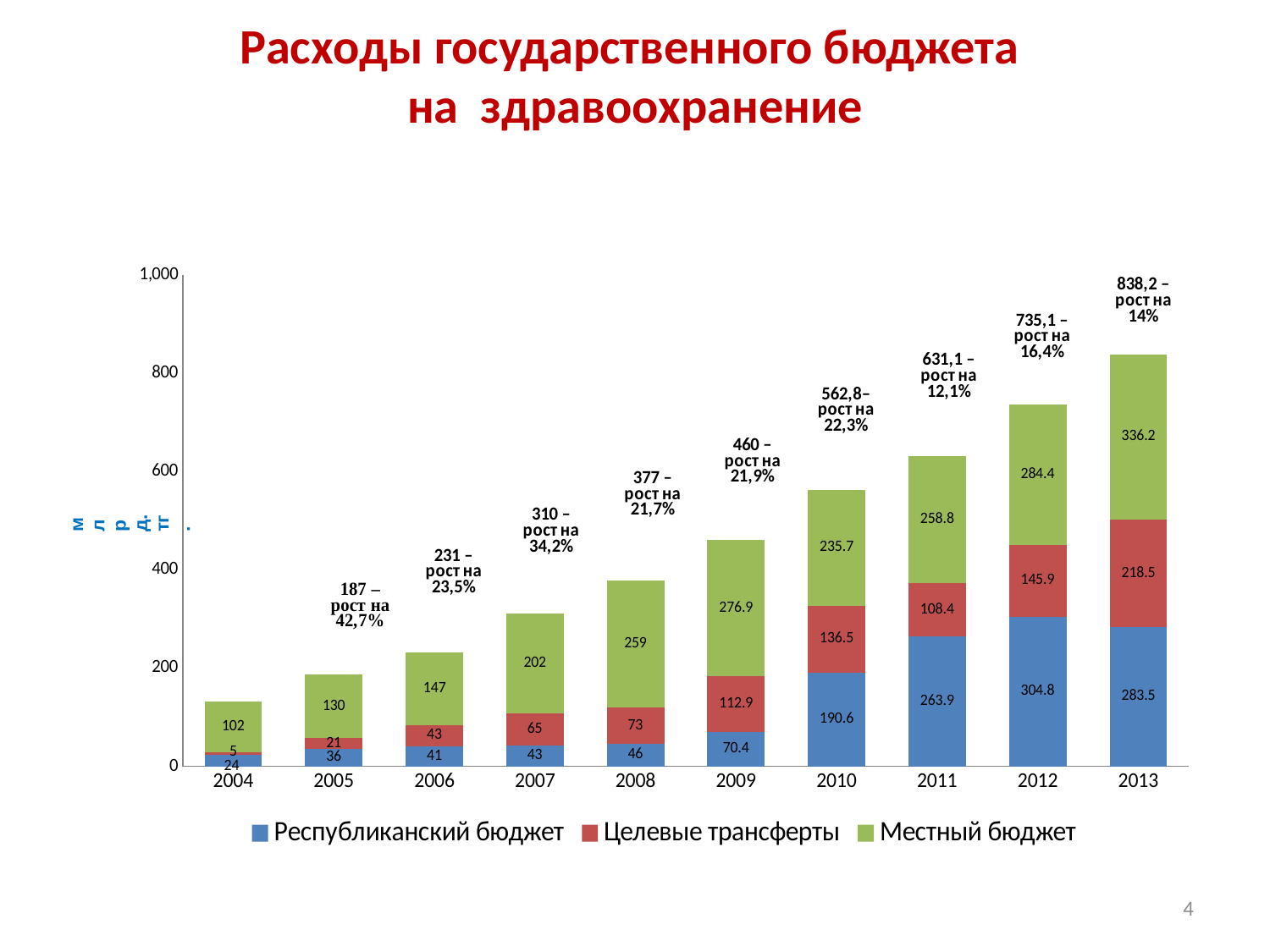
Do the total bar heights rise or fall from 2004 to 2013? Rise In 2011, which is larger: Республиканский бюджет or Целевые трансферты? Республиканский бюджет What growth percentage is annotated above the 2007 bar? 34,2% What is the value of Республиканский бюджет for 2010? 190.6 How many series does the legend list? 3 How many years are shown on the x axis? 10 What kind of chart is shown on the slide? Stacked bar chart Which year has the lowest total stacked bar? 2004 What is the value of Целевые трансферты for 2007? 65 Which year has the highest total stacked bar? 2013 What is the difference between the Местный бюджет values for 2013 and 2012? 51.8 What is the value of Местный бюджет for 2013? 336.2